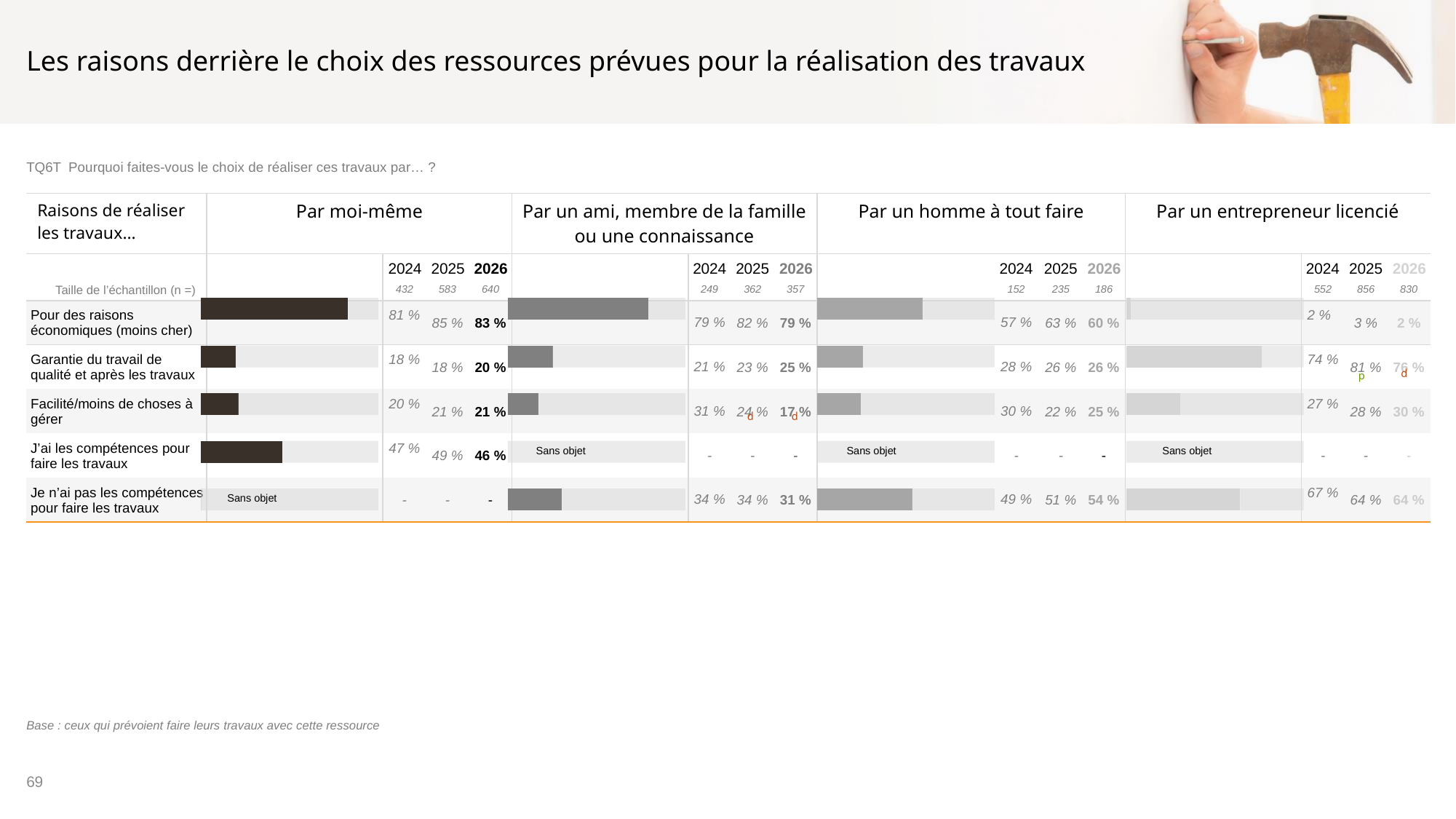
In the 'Par moi-même' chart, by how much did 'Pour des raisons économiques (moins cher)' change from 2024 to 2025? 4 percentage points In the 'Par un ami, membre de la famille ou une connaissance' chart, what is the difference between the 2024 and 2026 values for 'Facilité/moins de choses à gérer'? 14 percentage points In the 'Par un ami, membre de la famille ou une connaissance' chart, does the value for 'Facilité/moins de choses à gérer' rise or fall from 2024 to 2026? Fall In the 'Par un homme à tout faire' chart, which reason has the highest 2026 value? Pour des raisons économiques (moins cher) In the 'Par moi-même' chart, what is the 2024 value for 'J'ai les compétences pour faire les travaux'? 47 % In the 'Par un entrepreneur licencié' chart, which reason has the lowest 2026 value? Pour des raisons économiques (moins cher) What is the 2026 sample size (n) for the 'Par un entrepreneur licencié' chart? 830 In the 'Par un entrepreneur licencié' chart, what is the 2025 value for 'Garantie du travail de qualité et après les travaux'? 81 % In the 'Par un homme à tout faire' chart, which is larger in 2026: 'Pour des raisons économiques (moins cher)' or 'Je n'ai pas les compétences pour faire les travaux'? Pour des raisons économiques (moins cher) What kind of chart is used to show the values in each column? Bar chart How many reasons (row categories) are listed in the charts? 5 In the 'Par moi-même' chart, what is the 2026 value for 'Pour des raisons économiques (moins cher)'? 83 %